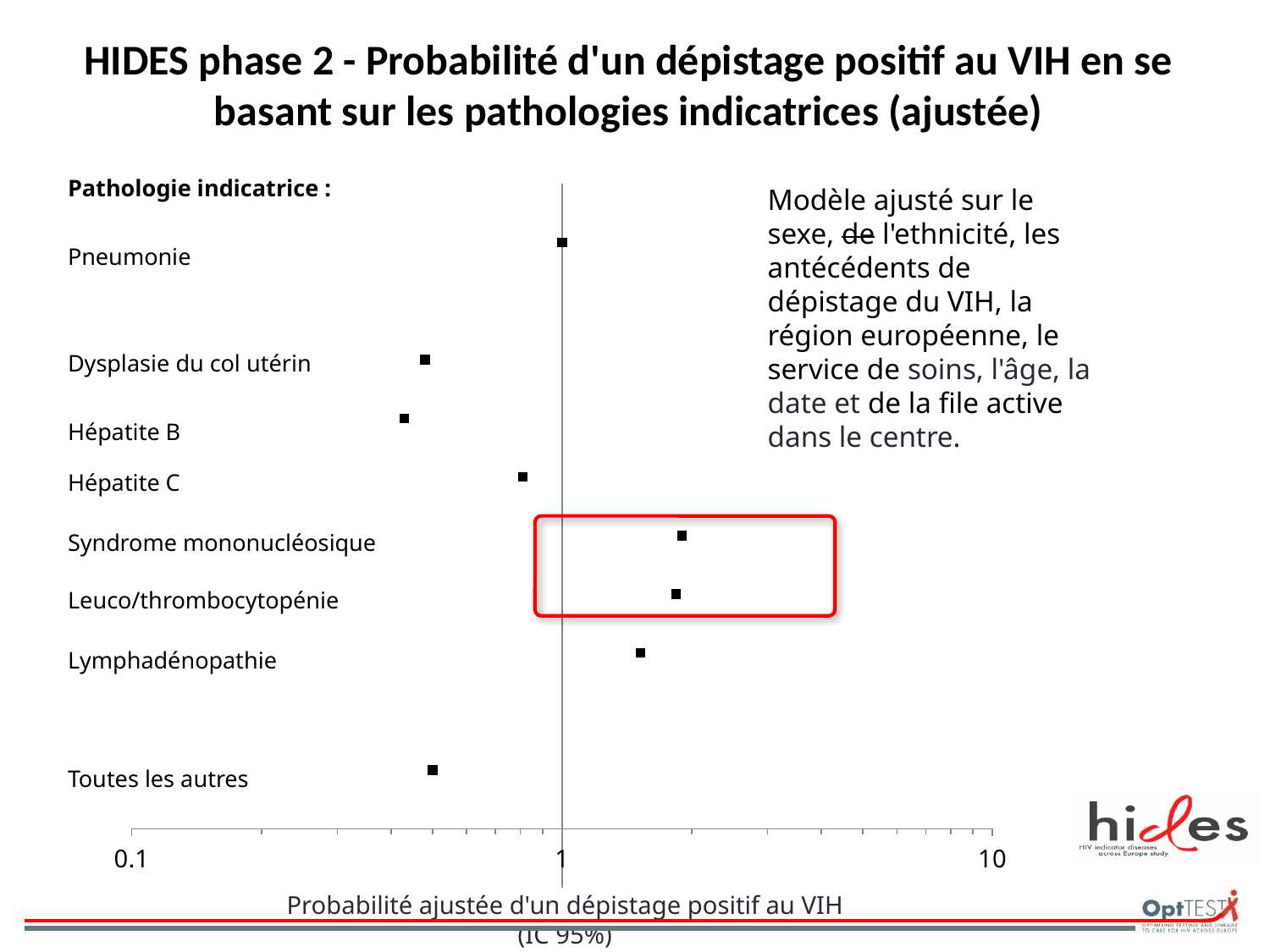
Is the value for Lymphadénopathie greater or less than 1? greater Is the value for Syndrome mononucléosique greater or less than 1? greater What is the label of the x axis? Probabilité ajustée d'un dépistage positif au VIH (IC 95%) What kind of chart is shown on the slide? Scatter (dot) plot Is the value for Dysplasie du col utérin greater or less than 1? less Which two pathologies are highlighted by the red box on the chart? Syndrome mononucléosique and Leuco/thrombocytopénie How many indicator pathologies are plotted on the chart? 8 Which has the larger value, Hépatite B or Hépatite C? Hépatite C Which has the larger value, Lymphadénopathie or Syndrome mononucléosique? Syndrome mononucléosique